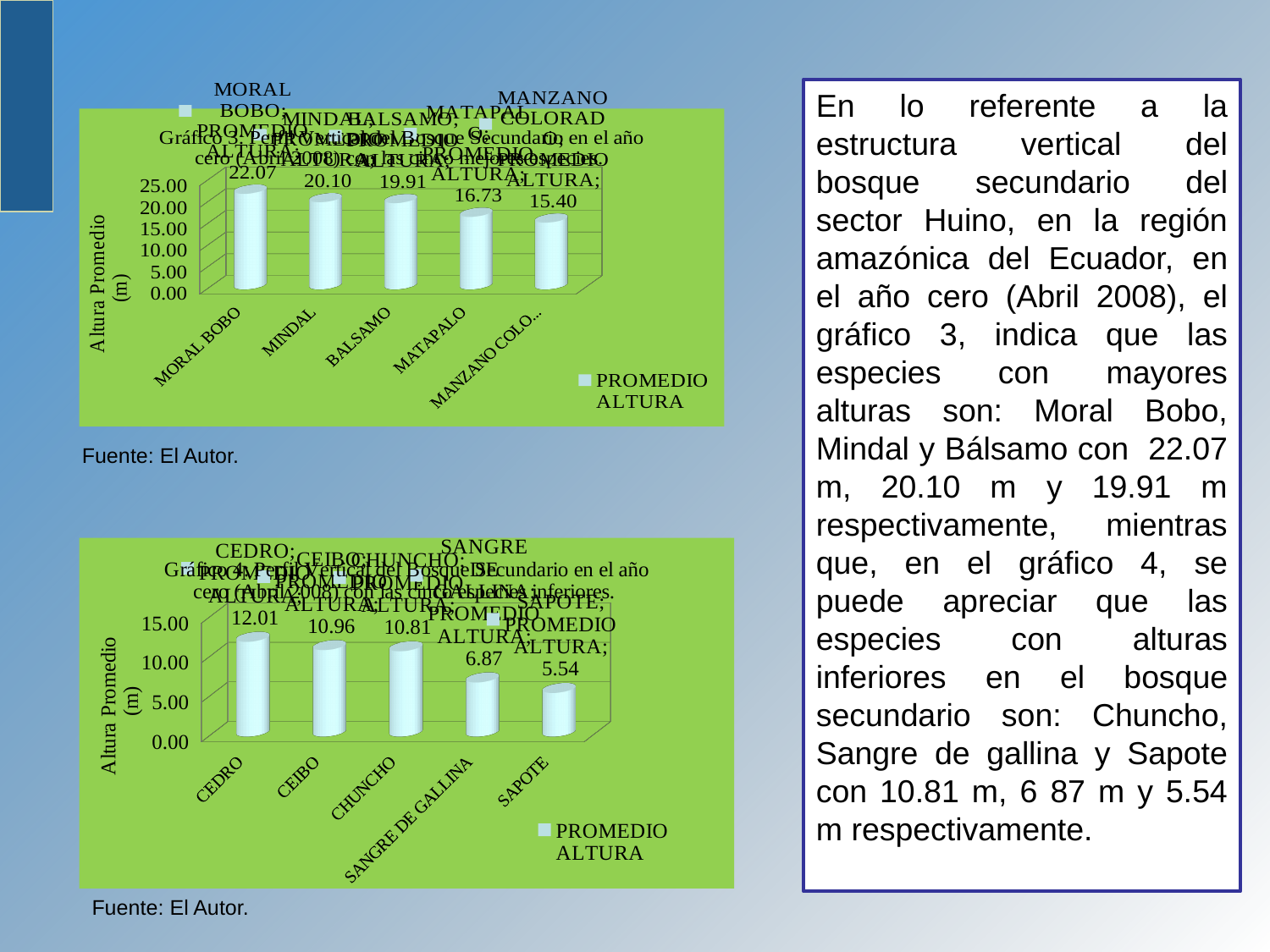
In the top chart, what is the difference between the values for MORAL BOBO and BALSAMO? 2.16 In the bottom chart, do the values rise or fall from left to right along the x axis? fall In the bottom chart, which category has the highest value? CEDRO In the top chart, which category has the lowest value? MANZANO COLORADO In the bottom chart, which is larger, the value for CHUNCHO or the value for SAPOTE? CHUNCHO In the bottom chart, what is the value for CEDRO? 12.01 In the top chart, how many categories are shown on the x axis? 5 What kind of chart is the top chart? bar chart In the bottom chart, what is the difference between the values for CEIBO and SAPOTE? 5.42 In the top chart, what is the value for MORAL BOBO? 22.07 In the bottom chart, what is the value for SANGRE DE GALLINA? 6.87 In the top chart, what is the value for MATAPALO? 16.73